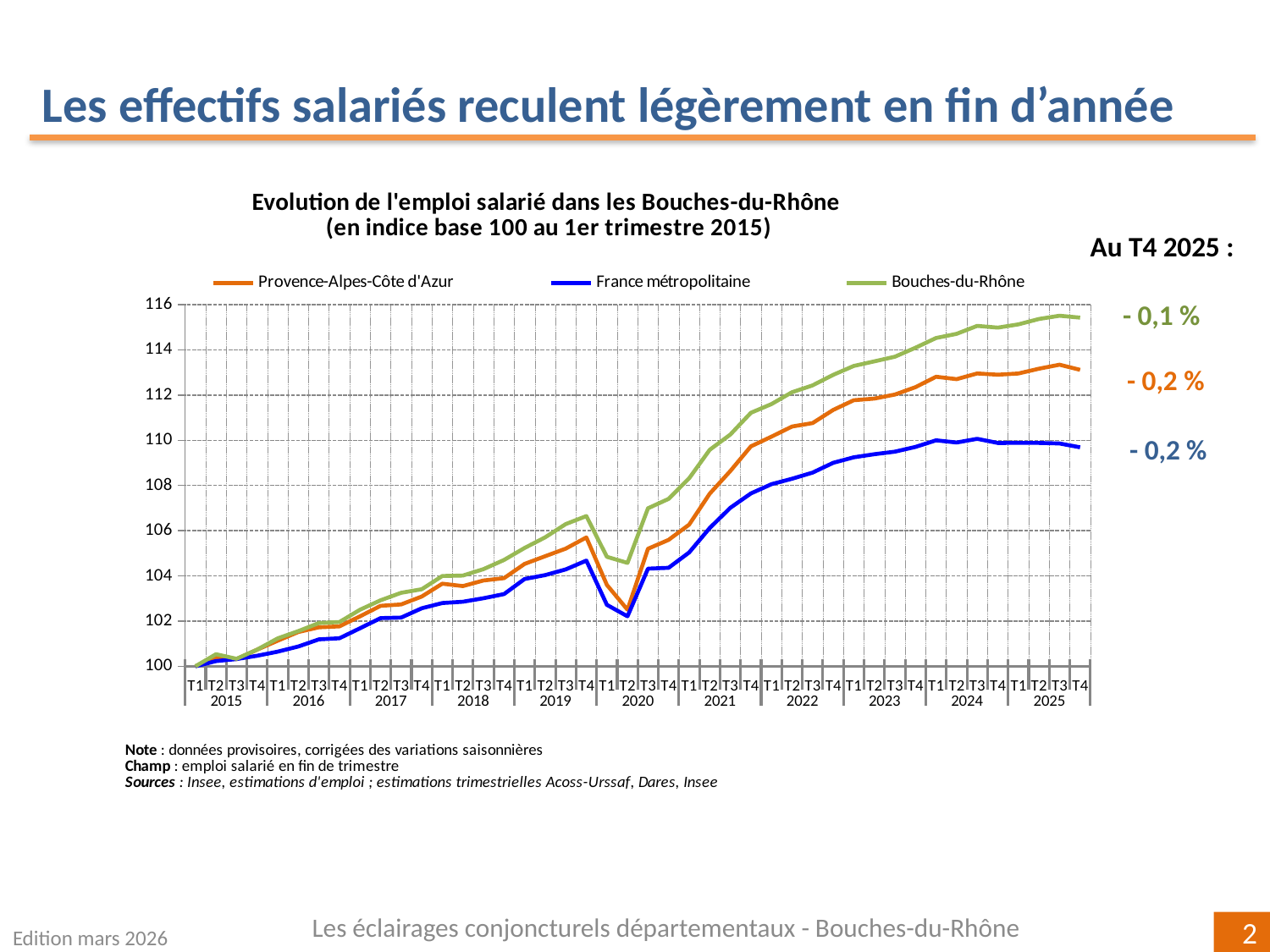
What is the title of the chart? Evolution de l'emploi salarié dans les Bouches-du-Rhône (en indice base 100 au 1er trimestre 2015) How many series does the legend list? 3 Which series has the lowest index value at T4 2025? France métropolitaine Which series has the highest index value at T4 2025? Bouches-du-Rhône Is the value for Bouches-du-Rhône at T4 2025 greater or less than 114? greater Is the value for Provence-Alpes-Côte d'Azur at T4 2025 greater or less than 112? greater According to the annotation, what is the change at T4 2025 for Bouches-du-Rhône? - 0,1 % At T4 2025, which is higher: Bouches-du-Rhône or France métropolitaine? Bouches-du-Rhône What kind of chart is shown on the slide? line chart Which series is drawn in blue? France métropolitaine Overall, do the index values rise or fall from T1 2015 to T4 2025? rise Is the value for France métropolitaine at T2 2020 greater or less than 104? less